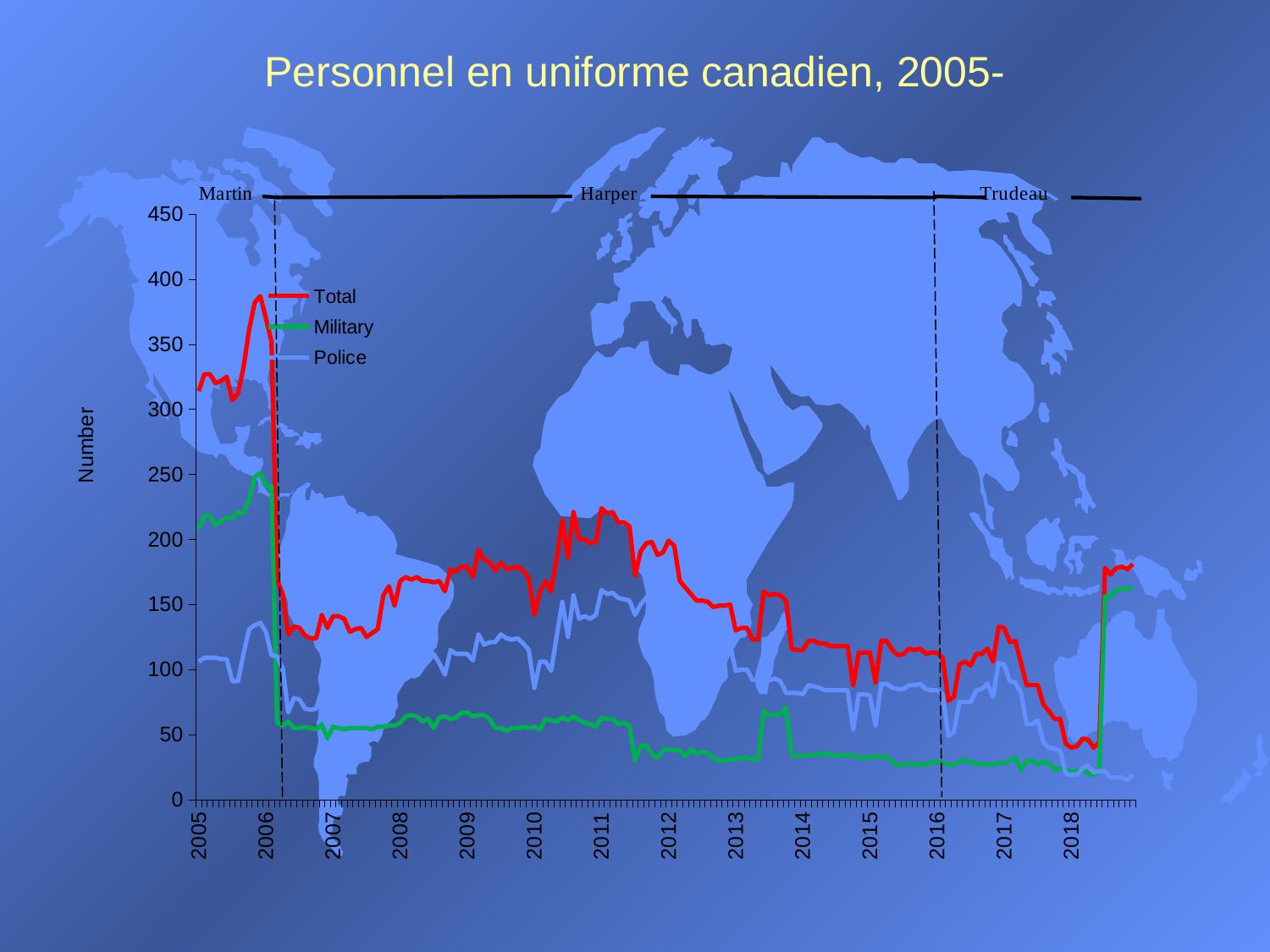
What is the title of the chart? Personnel en uniforme canadien, 2005- What kind of chart is shown on the slide? line chart Which series reaches the highest value on the chart? Total Is the value of the Military series during 2017 greater or less than 50? less Does the Total series overall rise or fall from 2005 to 2018? fall How many series does the legend list? 3 Is the value of the Police series at the end of 2018 greater or less than 50? less Is the peak value of the Total series in early 2006 greater or less than 350? greater Which series is larger during 2012, Military or Police? Police What is the label on the vertical axis? Number